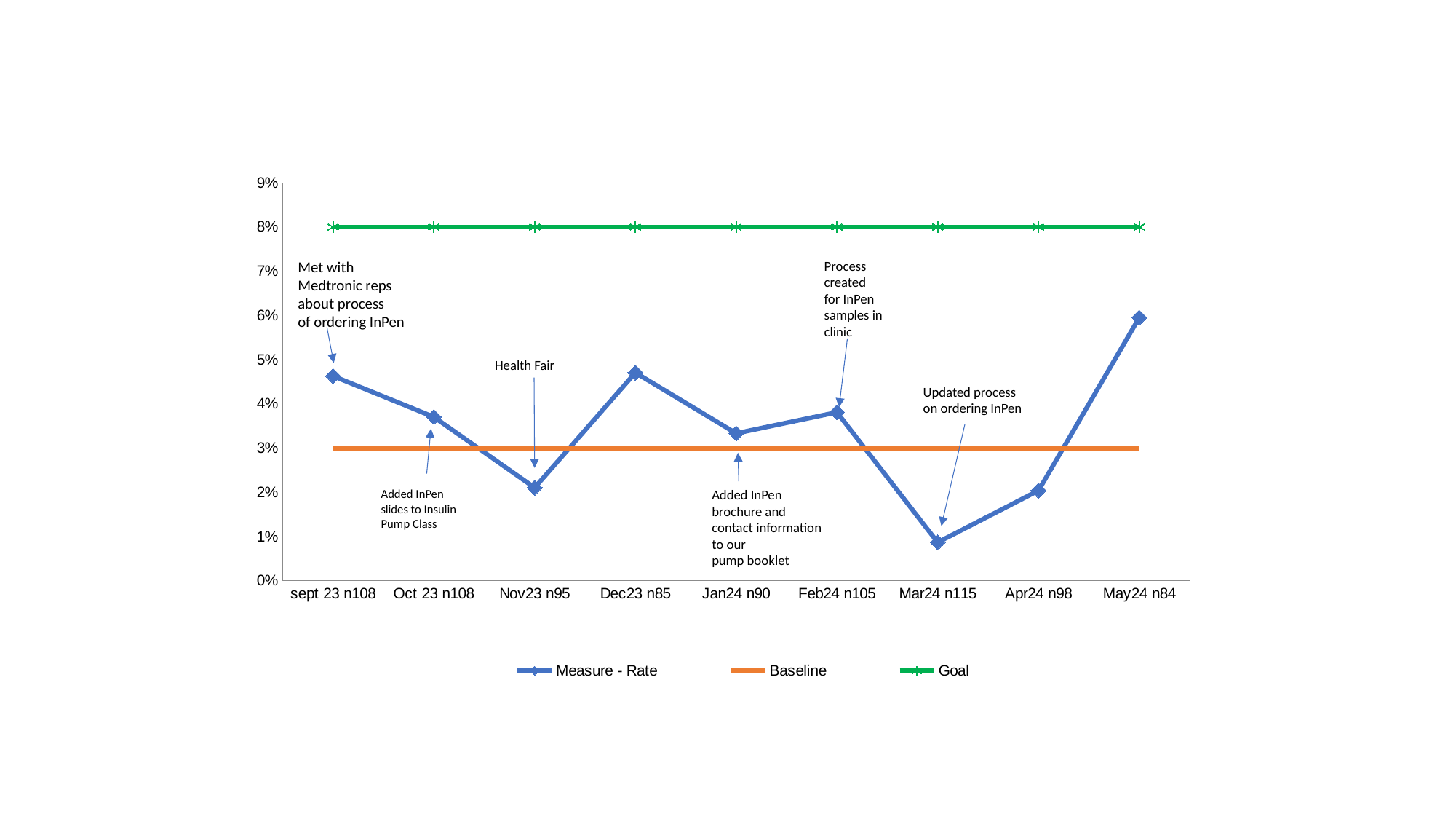
How many series does the legend list? 3 How many categories are shown along the x axis? 9 What value does the Goal line sit at? 8% Which category has the highest Measure - Rate value? May24 n84 What kind of chart is shown on the slide? line chart Is the Measure - Rate value for May24 n84 greater or less than 5%? greater Is the Measure - Rate value for Nov23 n95 greater or less than 3%? less What value does the Baseline line sit at? 3% Which category has the lowest Measure - Rate value? Mar24 n115 Does the Measure - Rate line rise or fall from Mar24 n115 to May24 n84? rise What annotation is attached to the Nov23 n95 data point? Health Fair Which has the larger Measure - Rate value, Dec23 n85 or Jan24 n90? Dec23 n85